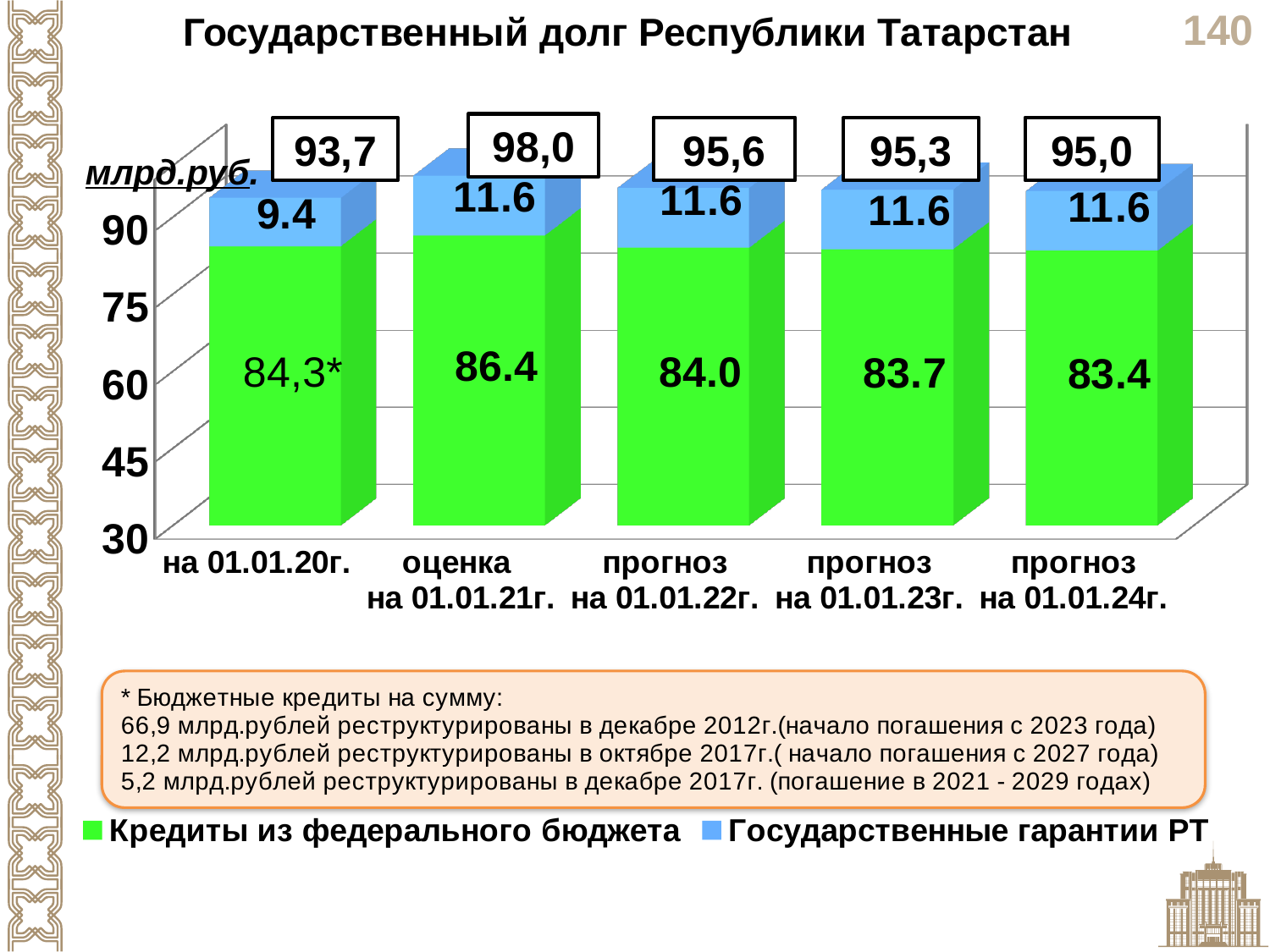
Which category has the highest total state debt? оценка на 01.01.21г. How many categories are shown on the x axis? 5 What is the value of Государственные гарантии РТ for на 01.01.20г.? 9.4 How many series does the legend list? 2 What is the total shown above the bar for прогноз на 01.01.22г.? 95,6 What is the value of Кредиты из федерального бюджета for оценка на 01.01.21г.? 86.4 What is the difference between the Кредиты из федерального бюджета values for оценка на 01.01.21г. and прогноз на 01.01.22г.? 2.4 Which is larger: Кредиты из федерального бюджета for прогноз на 01.01.23г. or for прогноз на 01.01.24г.? прогноз на 01.01.23г. What kind of chart is shown on the slide? stacked bar chart What is the value of Кредиты из федерального бюджета for прогноз на 01.01.24г.? 83.4 What is the title of the chart? Государственный долг Республики Татарстан Which category has the lowest total state debt? на 01.01.20г.